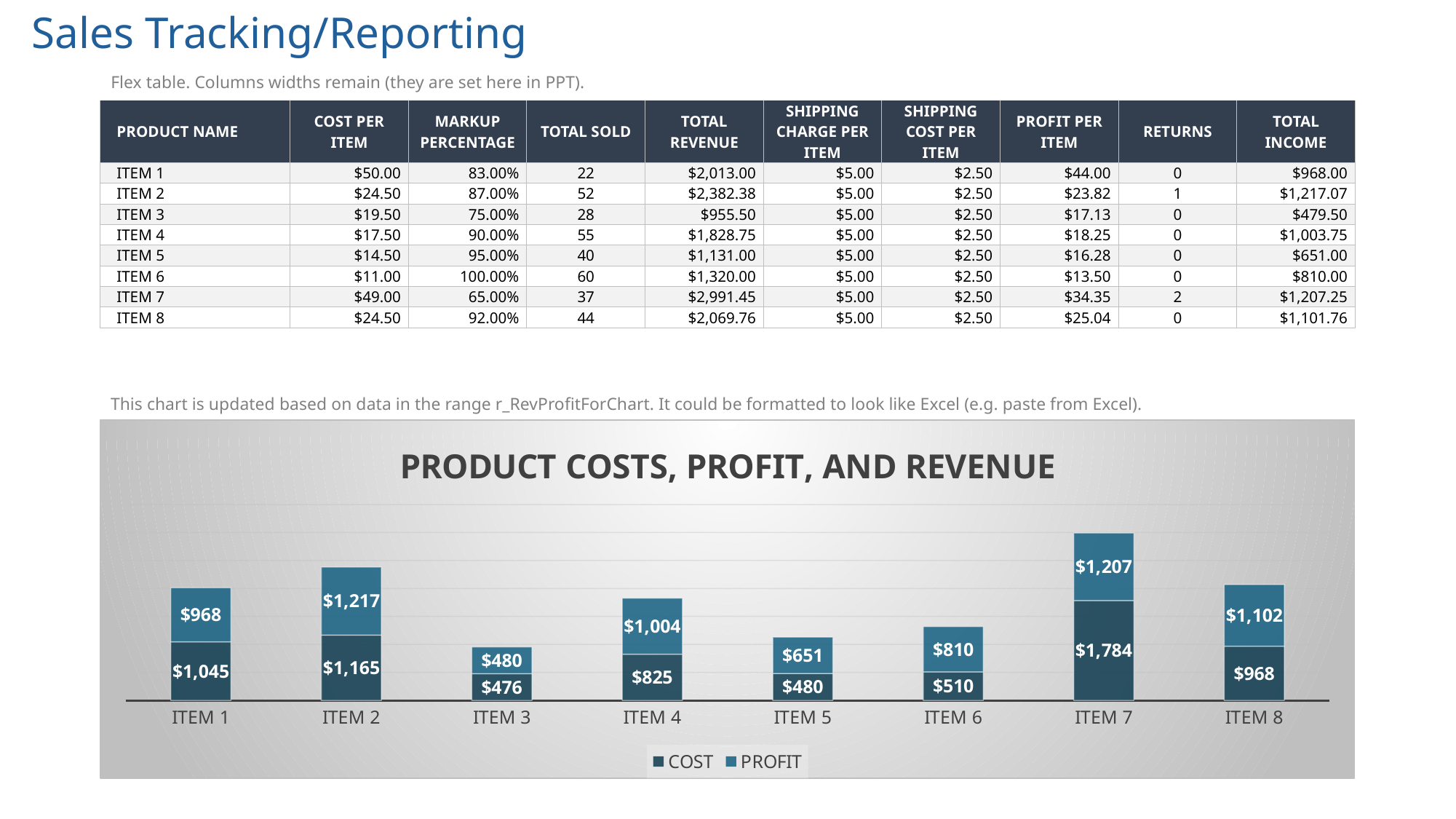
What is the total of the stacked bar for ITEM 1 (COST plus PROFIT)? $2,013 What is the PROFIT value for ITEM 4 in the chart? $1,004 What is the COST value for ITEM 7 in the chart? $1,784 How many items are shown on the x axis of the chart? 8 Which item has the highest COST in the chart? ITEM 7 Which is larger for ITEM 6, COST or PROFIT? PROFIT What is the difference between the COST and PROFIT values for ITEM 7? $577 What type of chart is shown on the slide? stacked bar chart What is the title of the chart? PRODUCT COSTS, PROFIT, AND REVENUE Which item has the lowest PROFIT in the chart? ITEM 3 What is the COST value for ITEM 3 in the chart? $476 How many series does the chart legend list? 2